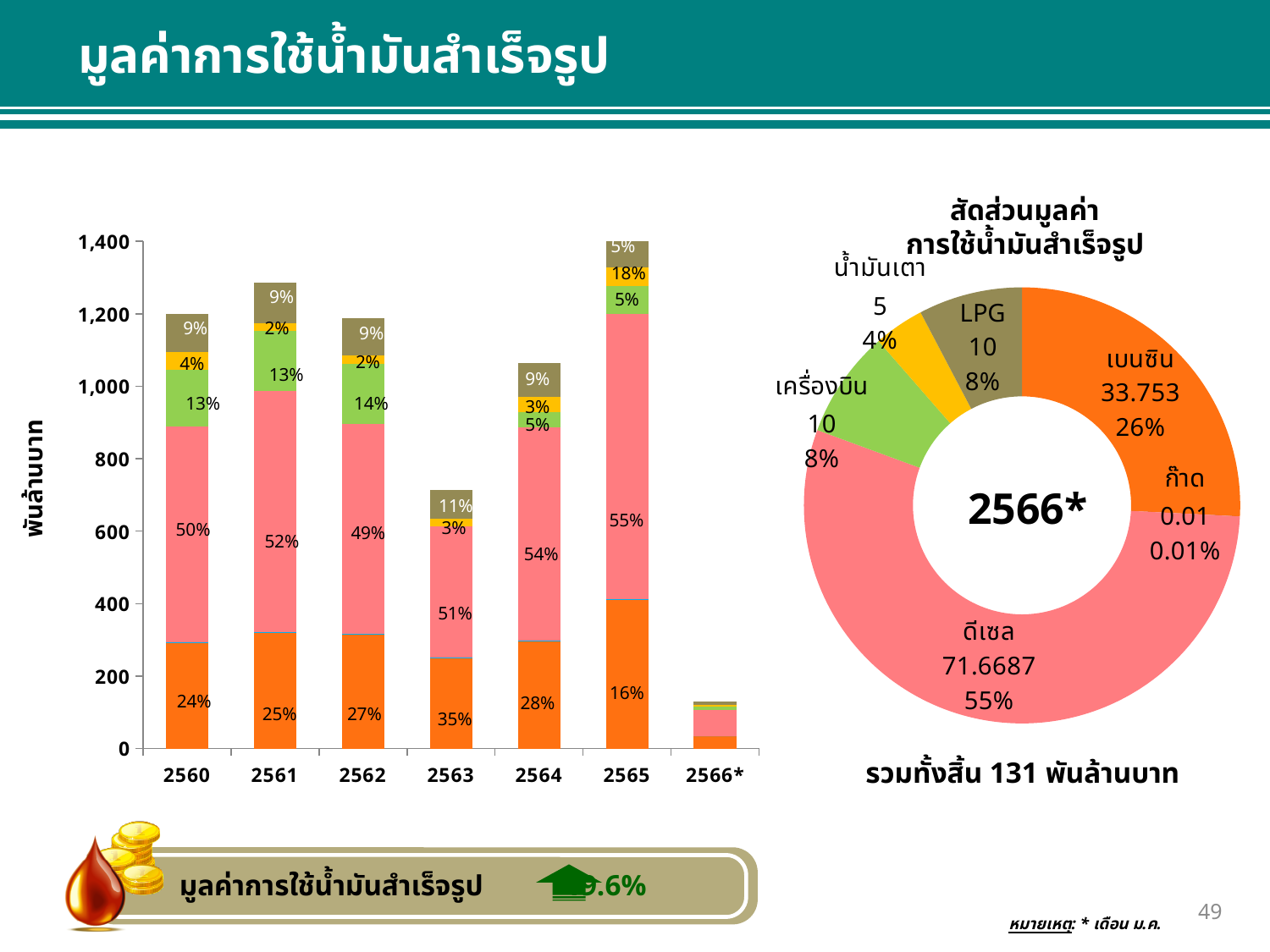
In the donut chart on the right, how many categories are shown? 6 In the donut chart on the right, which category has the largest slice? ดีเซล In the donut chart on the right, what is the total value stated below the chart? 131 พันล้านบาท In the donut chart on the right, which category has the smallest slice? ก๊าด In the bar chart on the left, how many years are shown on the x axis? 7 In the bar chart on the left, what percentage is labelled on the bottom orange segment of the 2563 bar? 35% In the donut chart on the right, what share of the total does เบนซิน account for? 26% What kind of chart is the chart on the left of the slide? Stacked bar chart In the bar chart on the left, is the total height of the 2563 bar greater or less than 800? less In the donut chart on the right, which is larger, the value for เครื่องบิน or the value for น้ำมันเตา? เครื่องบิน In the bar chart on the left, which year has the tallest bar? 2565 In the donut chart on the right, what is the value shown for ดีเซล? 71.6687